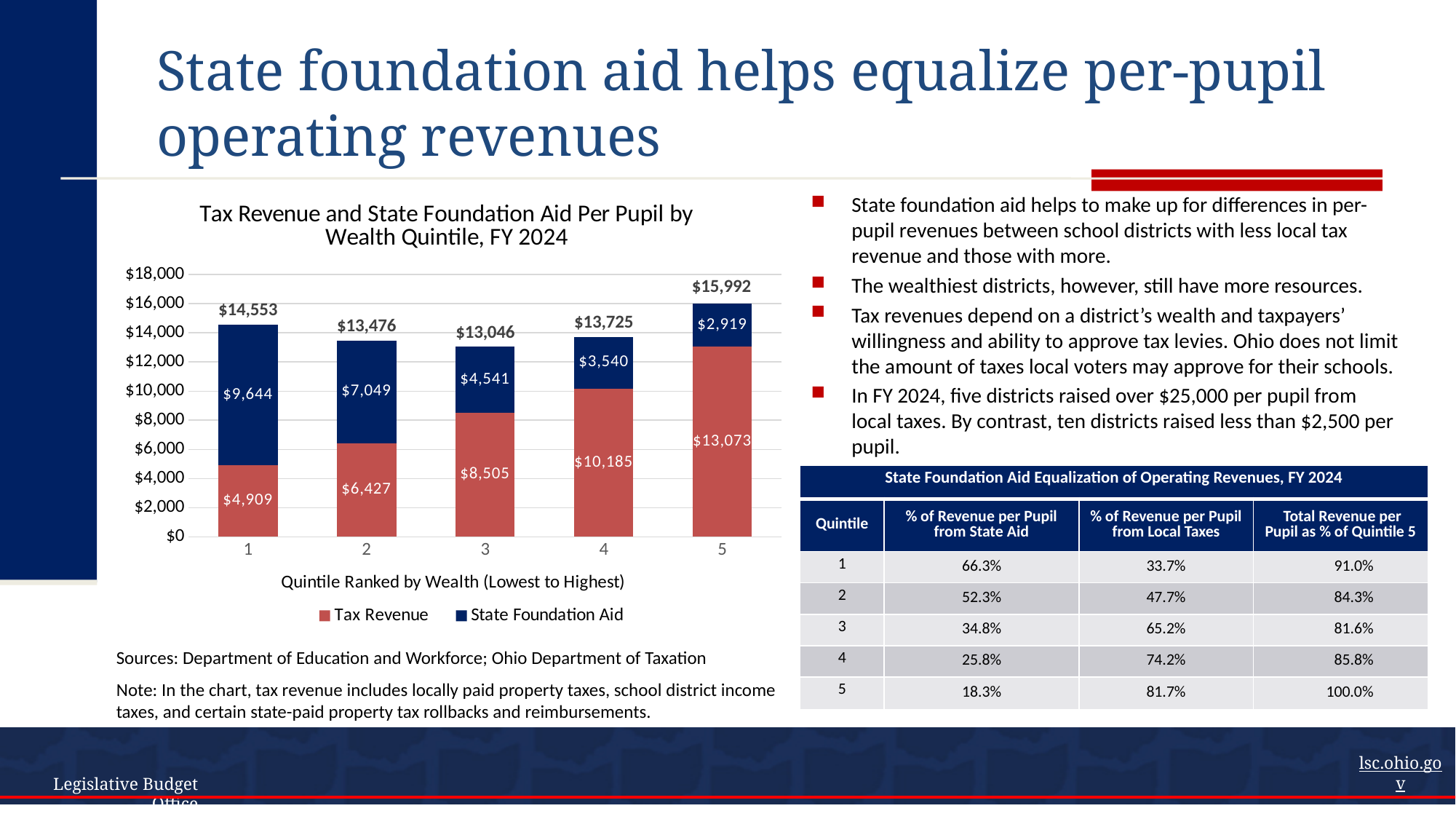
What is the difference between the Tax Revenue per pupil for quintile 5 and quintile 1? $8,164 How many series does the chart's legend list? 2 Does Tax Revenue per pupil rise or fall from quintile 1 to quintile 5? Rise What is the State Foundation Aid per pupil for quintile 4? $3,540 Which quintile has the highest total per-pupil revenue (tax revenue plus state foundation aid)? 5 What is the Tax Revenue per pupil for quintile 1? $4,909 Which quintile has the lowest State Foundation Aid per pupil? 5 Which is larger for quintile 2: Tax Revenue or State Foundation Aid? State Foundation Aid Is the total per-pupil revenue for quintile 2 greater or less than $14,000? less What kind of chart is shown on the slide? Stacked bar chart How many quintiles are shown on the x axis of the chart? 5 How much more State Foundation Aid per pupil does quintile 1 receive than quintile 5? $6,725